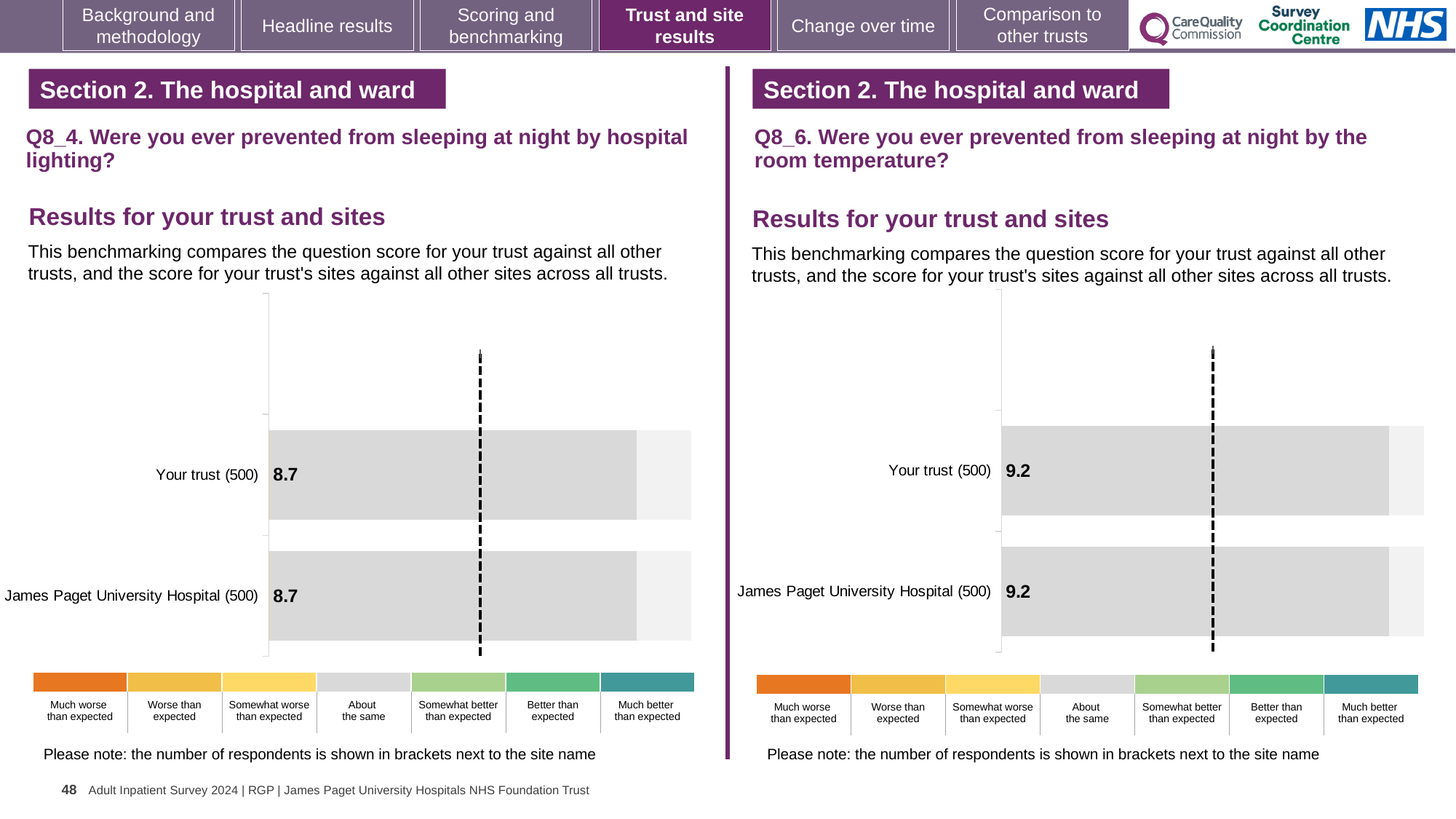
What kind of chart is the left chart (Q8_4, hospital lighting)? Bar chart What kind of chart is the right chart (Q8_6, room temperature)? Bar chart On the right chart (Q8_6, room temperature), what is the score for James Paget University Hospital? 9.2 On the left chart (Q8_4, hospital lighting), what is the score for James Paget University Hospital? 8.7 On the right chart (Q8_6, room temperature), how many respondents are shown in brackets next to James Paget University Hospital? 500 On the left chart (Q8_4, hospital lighting), what is the difference between the score for Your trust and the score for James Paget University Hospital? 0 On the right chart (Q8_6, room temperature), what is the score for Your trust? 9.2 How many bars are plotted on the left chart (Q8_4, hospital lighting)? 2 On the left chart (Q8_4, hospital lighting), how many respondents are shown in brackets next to Your trust? 500 How many bars are plotted on the right chart (Q8_6, room temperature)? 2 On the left chart (Q8_4, hospital lighting), what is the score for Your trust? 8.7 On the right chart (Q8_6, room temperature), what is the difference between the score for Your trust and the score for James Paget University Hospital? 0